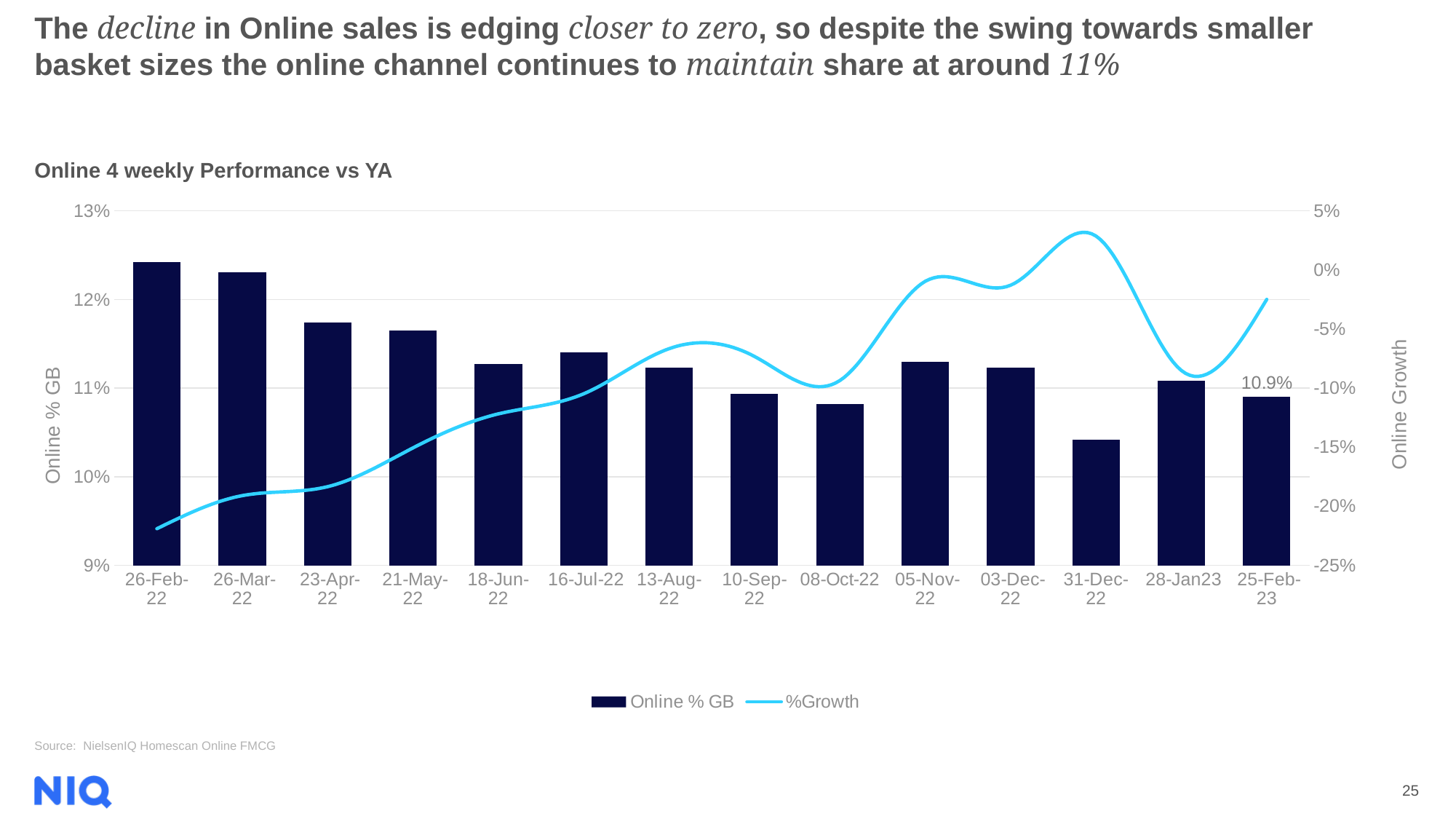
What kind of chart is shown? Combined bar and line chart Is the Online % GB value for 31-Dec-22 greater or less than 11%? less How many 4-weekly periods are shown on the x axis? 14 Which has the larger Online % GB value, 26-Feb-22 or 25-Feb-23? 26-Feb-22 Which period has the highest Online % GB bar? 26-Feb-22 What is the Online % GB value for 25-Feb-23? 10.9% Is the Online % GB value for 26-Feb-22 greater or less than 12%? greater Is the %Growth value for 31-Dec-22 greater or less than 0%? greater What are the two entries in the chart legend? Online % GB and %Growth Does the %Growth line rise or fall from 26-Feb-22 to 16-Jul-22? rises How many series does the legend list? 2 Which period has the lowest Online % GB bar? 31-Dec-22